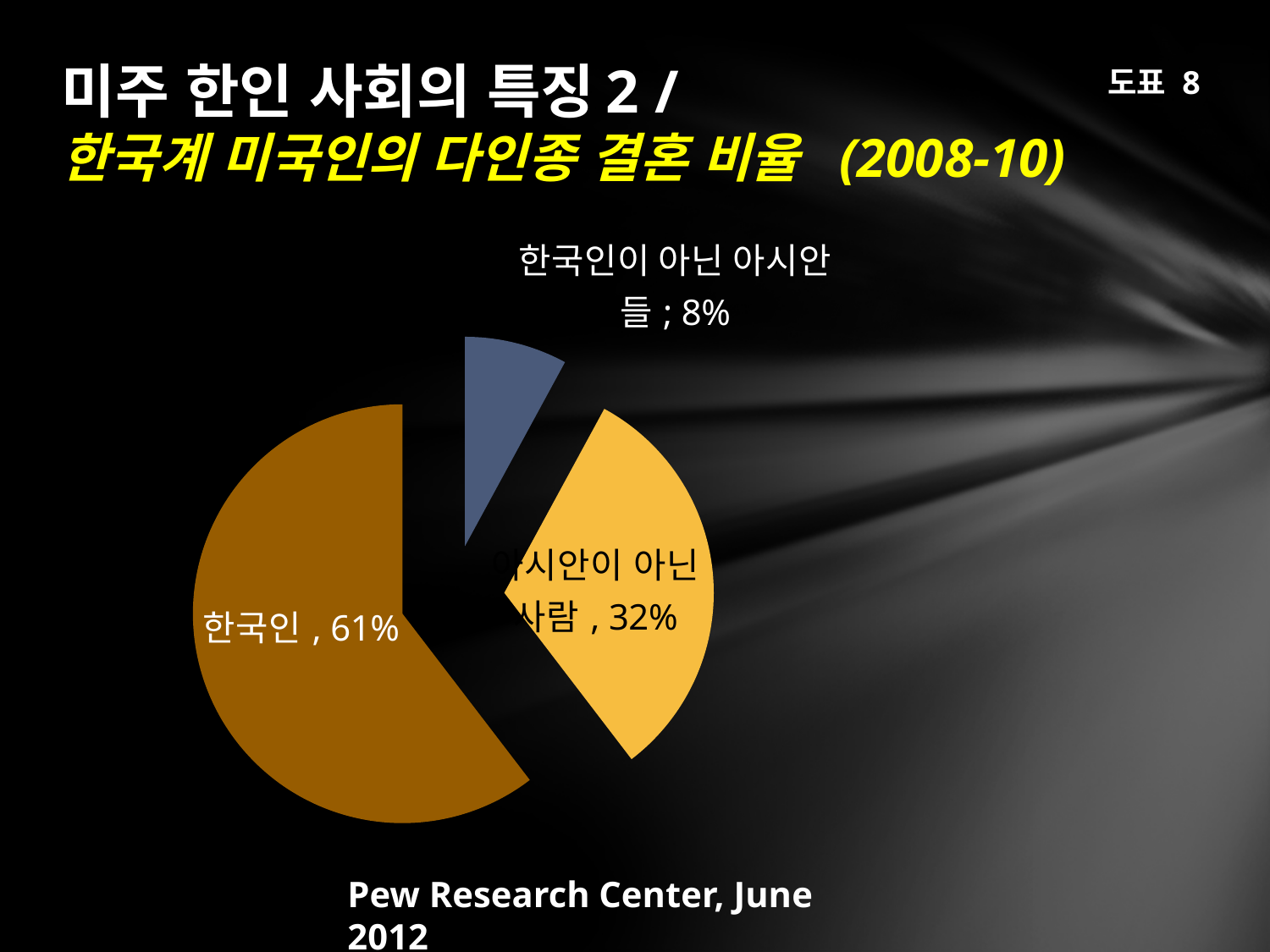
What kind of chart is shown on the slide? pie chart What percentage is shown for 한국인이 아닌 아시안들? 8% Which category has the smallest slice of the pie? 한국인이 아닌 아시안들 What is the difference in percentage points between 한국인 and 아시안이 아닌 사람? 29 Which is larger, the slice for 아시안이 아닌 사람 or the slice for 한국인이 아닌 아시안들? 아시안이 아닌 사람 What percentage is shown for 한국인? 61% What colour is the slice for 한국인이 아닌 아시안들? blue What is the difference in percentage points between 아시안이 아닌 사람 and 한국인이 아닌 아시안들? 24 How many slices does the pie chart have? 3 What source is cited below the chart? Pew Research Center, June 2012 What percentage is shown for 아시안이 아닌 사람? 32% Which category has the largest slice of the pie? 한국인